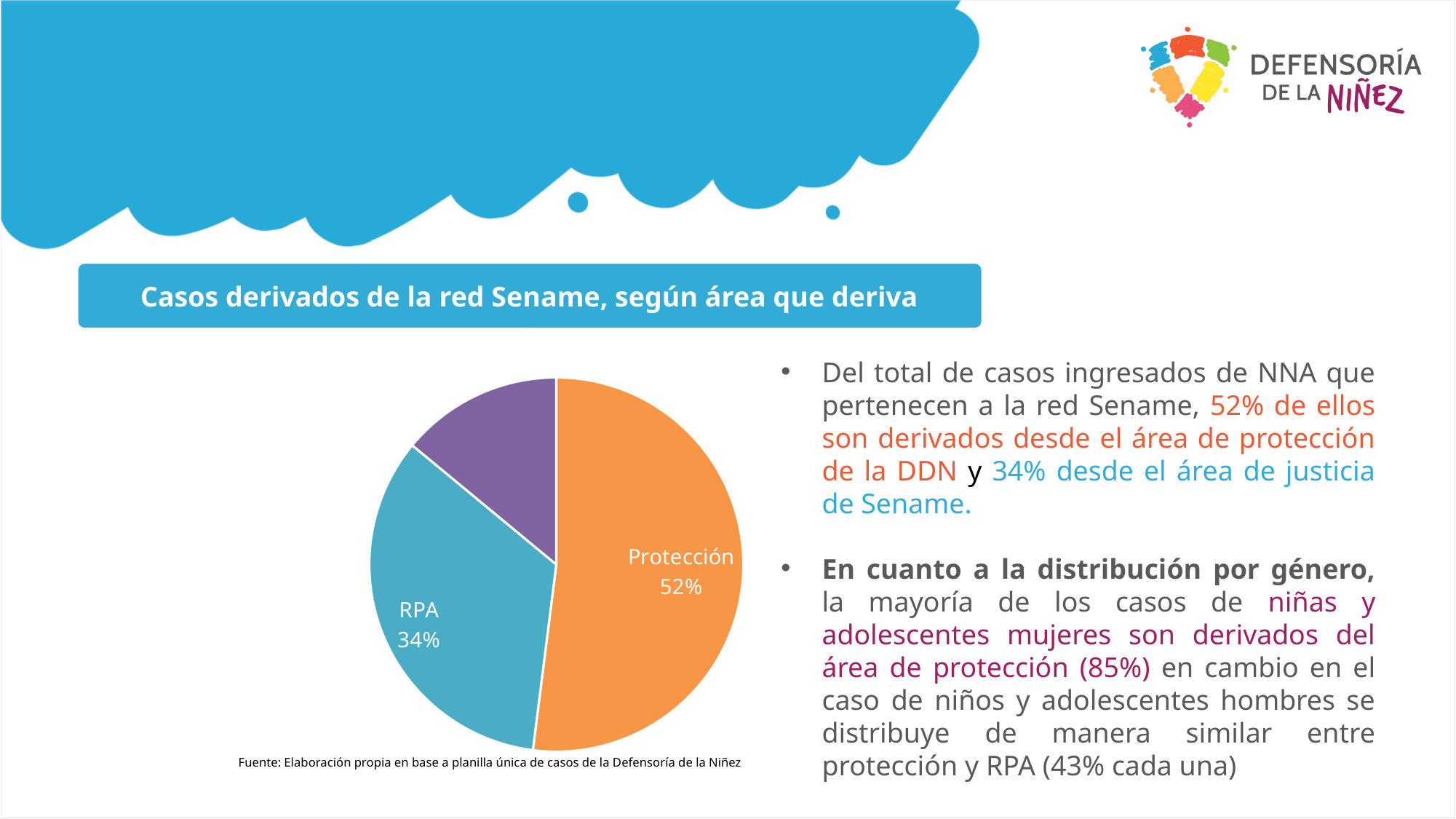
What share of the pie does RPA represent? 34% Which slice of the pie chart is the largest? Protección What is the value shown for the Protección slice? 52% What colour is the Protección slice? orange What kind of chart is shown on the slide? pie chart Which is larger, the Protección slice or the RPA slice? Protección What is the title of the chart? Casos derivados de la red Sename, según área que deriva What is the difference in percentage points between the Protección slice and the RPA slice? 18 percentage points How many slices does the pie chart have? 3 What share of the pie does Protección represent? 52% What is the value shown for the RPA slice? 34%